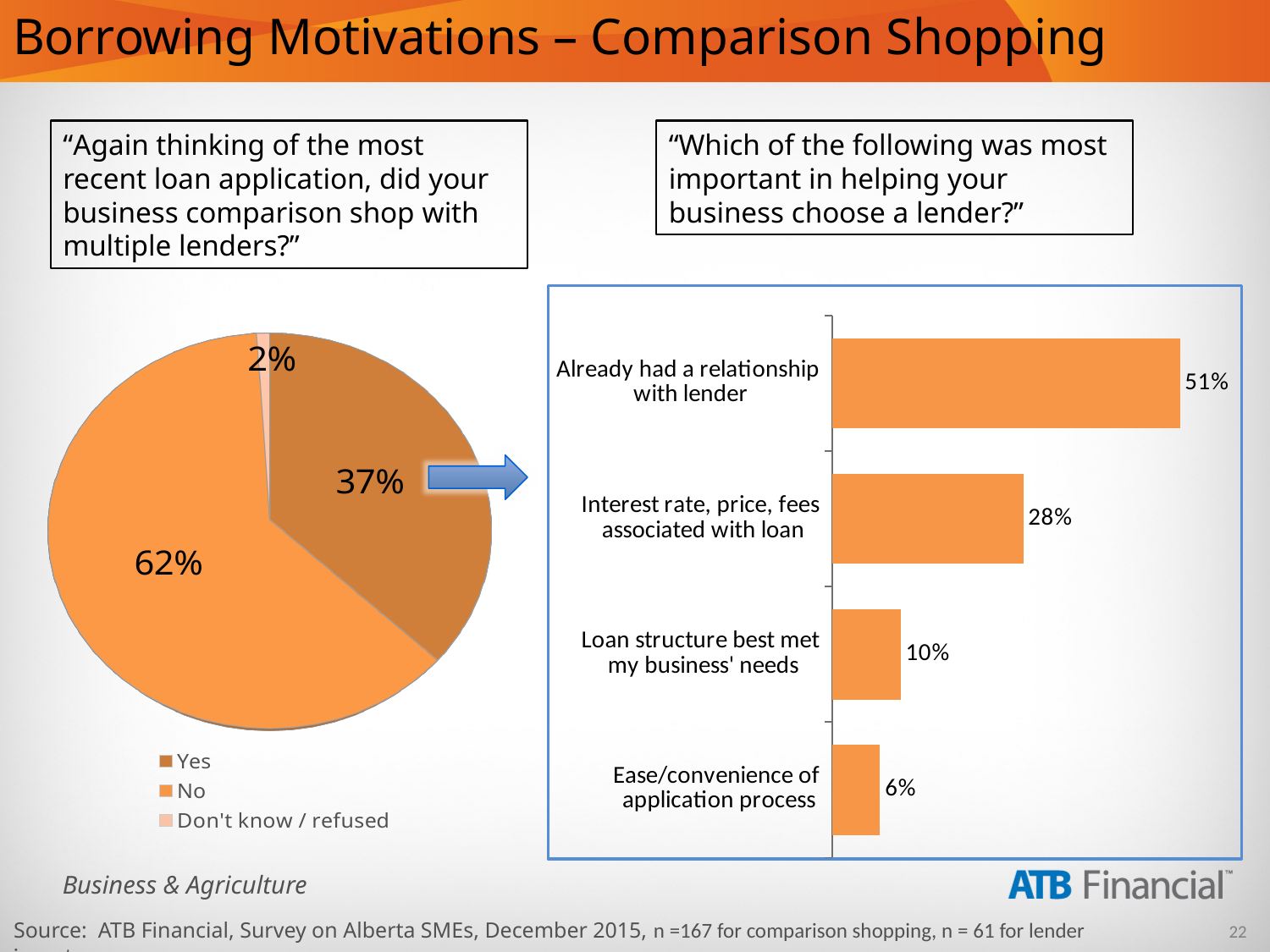
What type of chart is on the right side of the slide? Bar chart In the pie chart on the left, what is the difference between the "No" and "Yes" shares? 25% In the pie chart on the left, what share of respondents answered "No"? 62% In the pie chart on the left, how many slices are there? 3 In the pie chart on the left, what share is "Don't know / refused"? 2% In the pie chart on the left, which response has the largest slice? No In the bar chart on the right, what is the value for "Already had a relationship with lender"? 51% In the bar chart on the right, what is the value for "Interest rate, price, fees associated with loan"? 28% In the pie chart on the left, what share of respondents answered "Yes"? 37% In the bar chart on the right, which category has the lowest value? Ease/convenience of application process In the bar chart on the right, how many categories are shown? 4 In the bar chart on the right, what is the difference between "Already had a relationship with lender" and "Loan structure best met my business' needs"? 41%